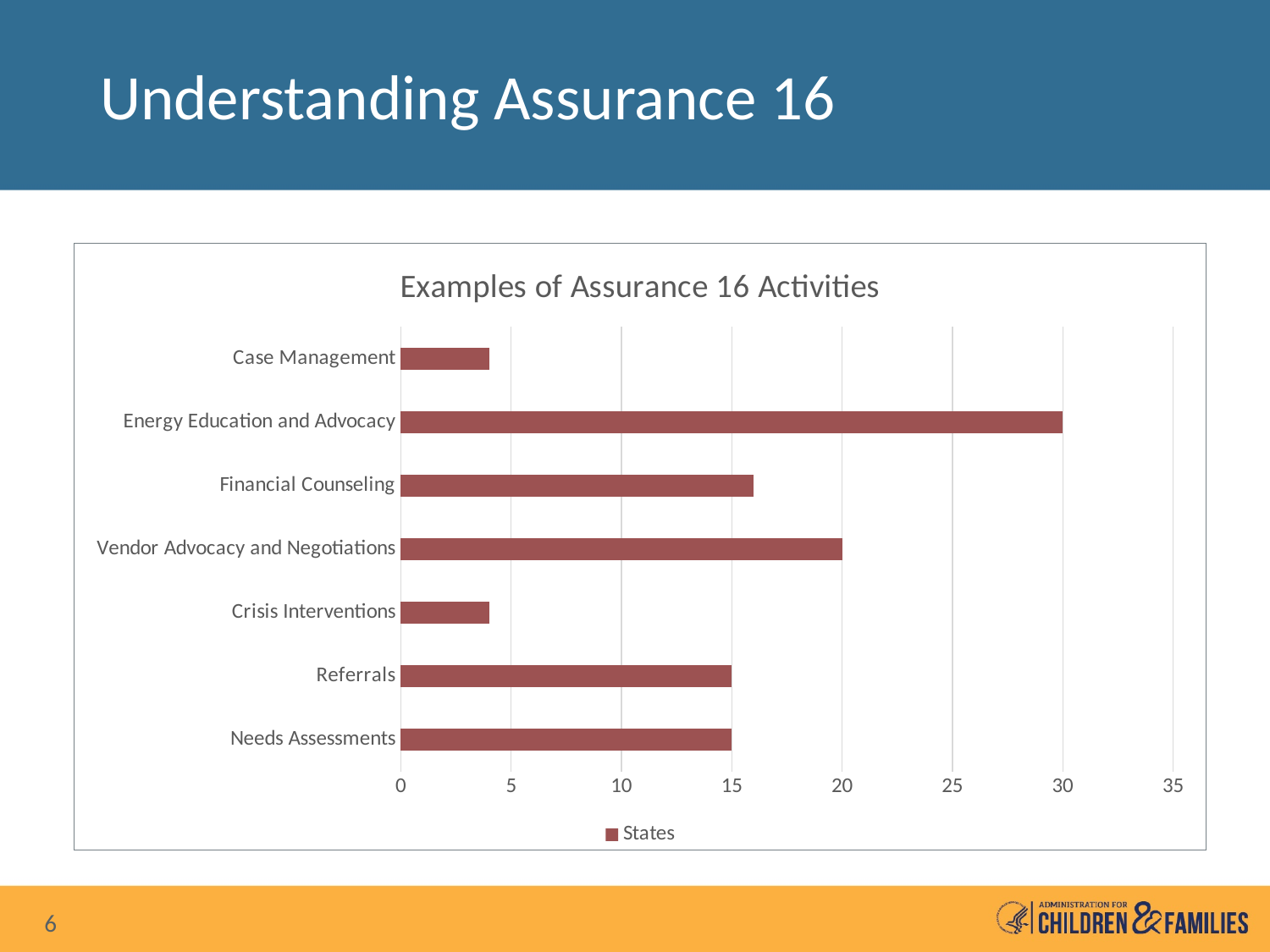
Is the value for Financial Counseling greater or less than 15? greater What is the value for Referrals? 15 Which activity has the highest number of states? Energy Education and Advocacy What is the title of the chart? Examples of Assurance 16 Activities What is the value for Vendor Advocacy and Negotiations? 20 Is the value for Case Management greater or less than 5? less What is the value for Energy Education and Advocacy? 30 What is the difference between the values for Energy Education and Advocacy and Vendor Advocacy and Negotiations? 10 How many activity categories are shown in the chart? 7 How many series does the legend list? 1 What type of chart is shown on the slide? bar chart Which is larger, the value for Vendor Advocacy and Negotiations or the value for Crisis Interventions? Vendor Advocacy and Negotiations